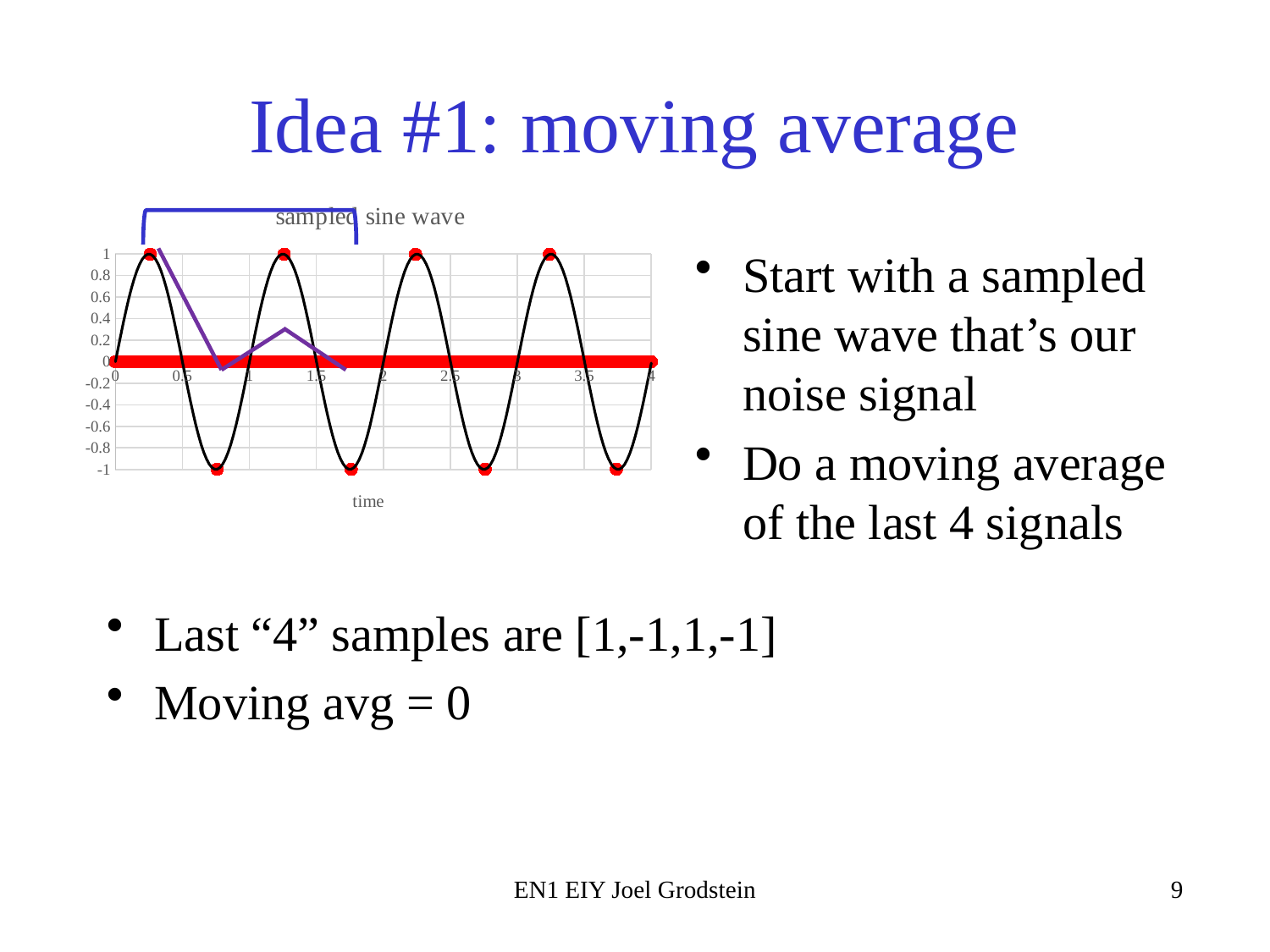
What kind of chart is shown on the slide? line chart How many troughs (marked with red dots at the bottom) does the sine wave have in the chart? 4 What is the difference between the peak value and the trough value of the sine wave? 2 Which is larger, the peak value of the sine wave or the value of the thick red moving-average line? the peak value of the sine wave How many peaks (marked with red dots at the top) does the sine wave have in the chart? 4 At what value does the thick red horizontal line (the moving average) sit on the chart? 0 What is the label on the x axis of the chart? time What is the minimum value reached by the sine wave in the chart? -1 What is the maximum value reached by the sine wave in the chart? 1 Is the peak value of the sine wave greater or less than 0.8? greater Is the trough value of the sine wave greater or less than -0.8? less What is the title of the chart? sampled sine wave